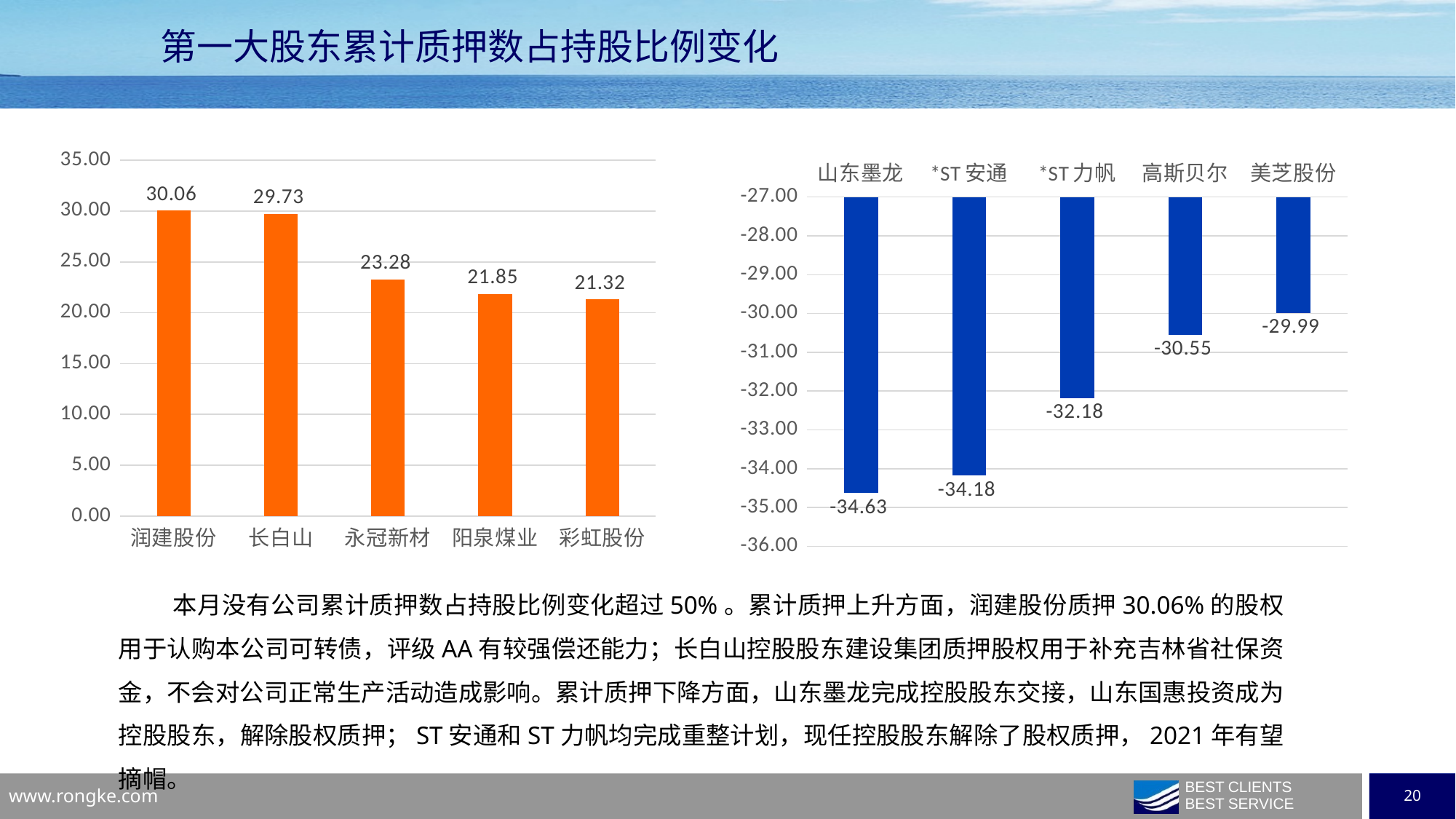
In the left chart, which category has the lowest value? 彩虹股份 In the right chart, which category has the highest (least negative) value? 美芝股份 What colour are the bars in the left chart? orange In the left chart, what is the value for 润建股份? 30.06 In the right chart, what is the value for 山东墨龙? -34.63 In the left chart, how many categories are shown? 5 In the left chart, do the values rise or fall from left to right along the x axis? fall In the right chart, what is the value for 高斯贝尔? -30.55 In the left chart, what is the value for 永冠新材? 23.28 In the left chart, what is the difference between the values for 润建股份 and 长白山? 0.33 What kind of chart is the right chart? bar chart In the right chart, which is larger, the value for *ST力帆 or the value for *ST安通? *ST力帆